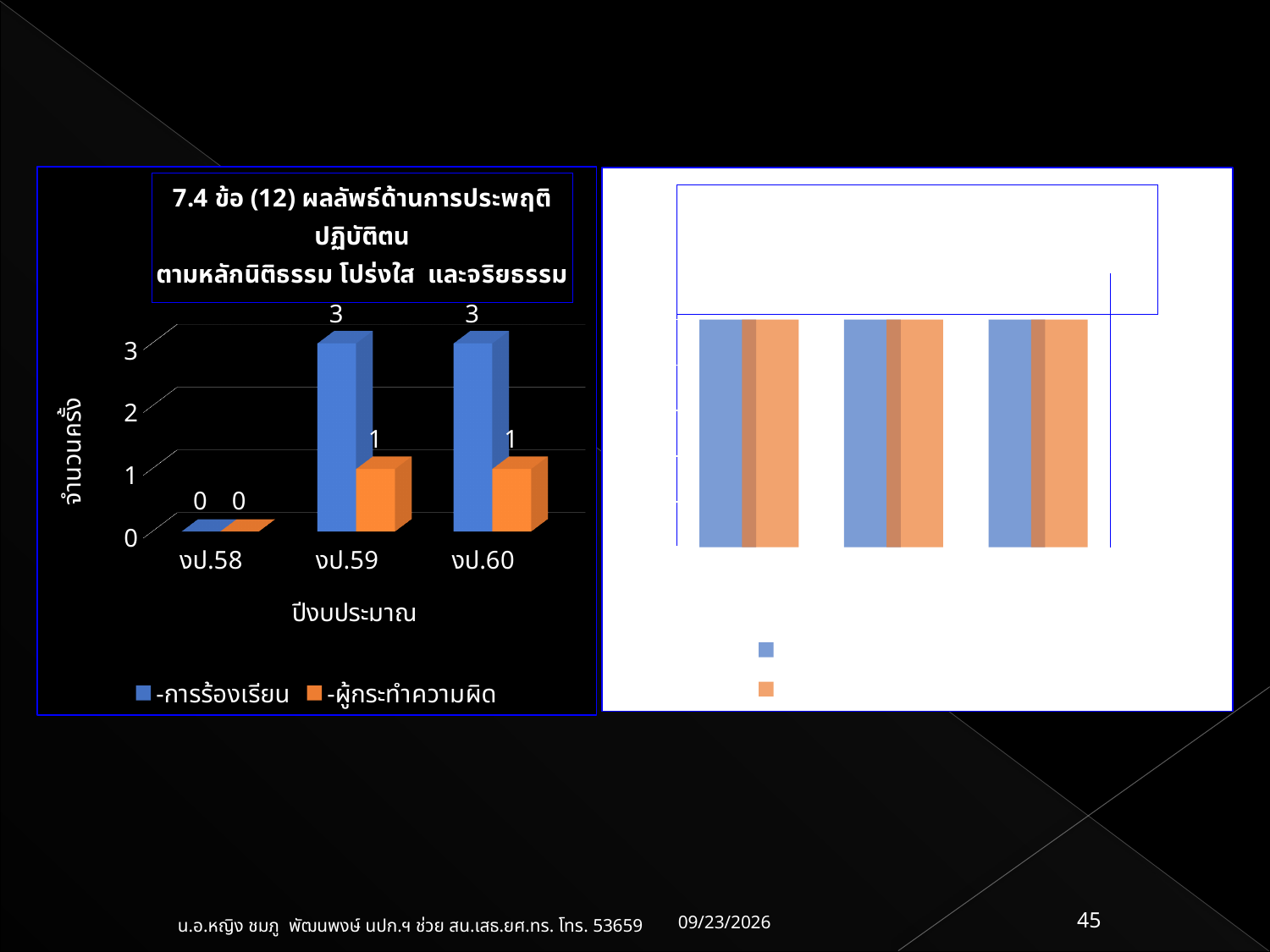
How many series does the legend of the left chart list? 2 What kind of chart is the left chart? bar chart On the left chart, what is the label of the y axis? จำนวนครั้ง On the left chart, what is the value of -การร้องเรียน for งป.58? 0 On the left chart, what is the value of -การร้องเรียน for งป.59? 3 How many categories are shown on the x axis of the left chart? 3 On the left chart, what is the value of -ผู้กระทำความผิด for งป.59? 1 On the left chart, which is larger for งป.59: -การร้องเรียน or -ผู้กระทำความผิด? -การร้องเรียน On the left chart, what is the value of -ผู้กระทำความผิด for งป.60? 1 On the left chart, which category has the lowest value for -การร้องเรียน? งป.58 On the left chart, what is the label of the x axis? ปีงบประมาณ On the left chart, what is the difference between -การร้องเรียน and -ผู้กระทำความผิด for งป.60? 2